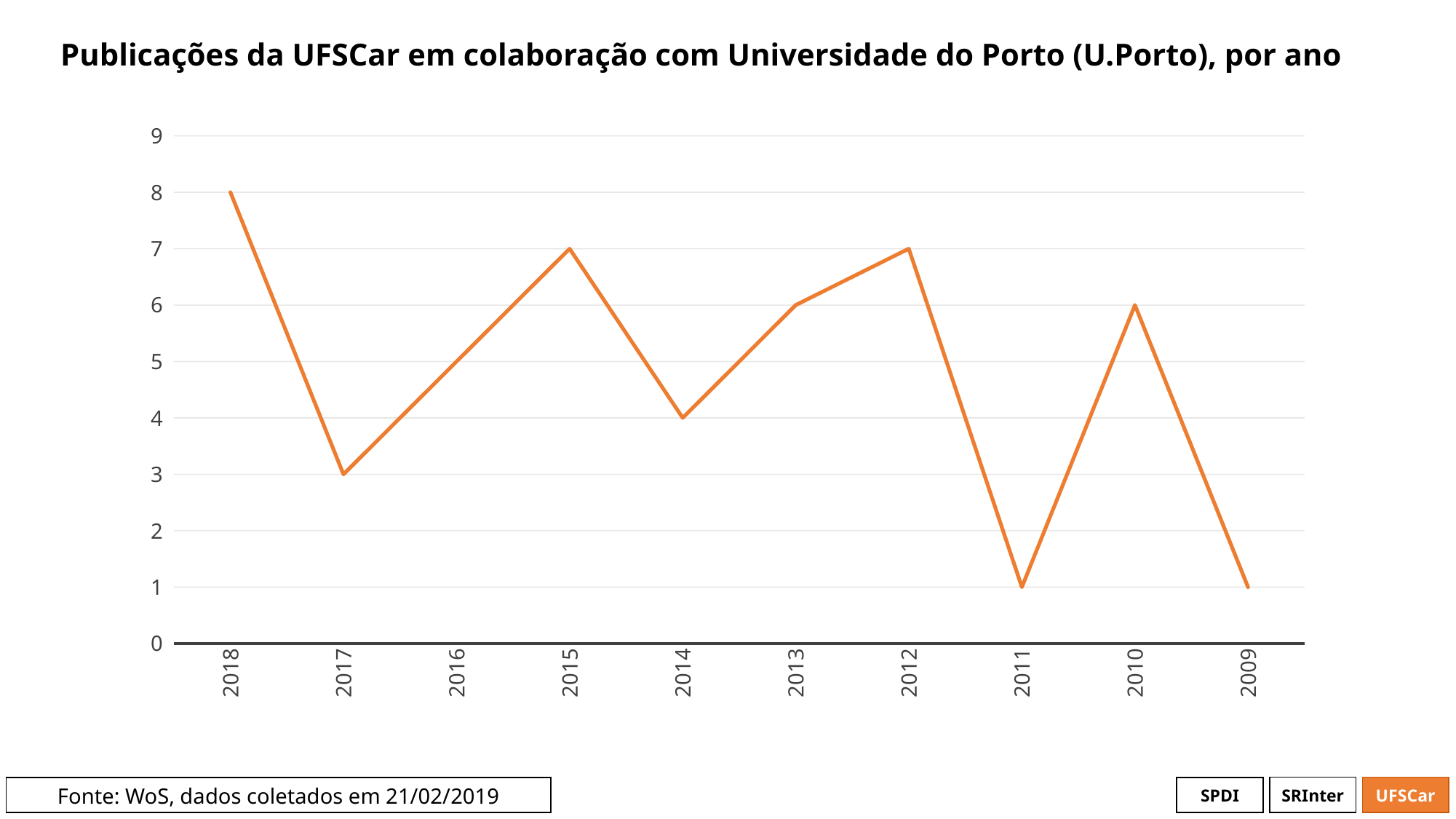
What is the difference between the values for 2018 and 2017? 5 What is the title of the chart? Publicações da UFSCar em colaboração com Universidade do Porto (U.Porto), por ano What is the value for 2012? 7 What type of chart is shown on the slide? line chart Which years share the lowest value? 2011 and 2009 How many years are plotted on the x axis? 10 What is the value for 2018? 8 Is the value for 2010 greater or less than 5? greater Which is larger, the value for 2015 or the value for 2014? 2015 What is the value for 2014? 4 What is the value for 2017? 3 Which year has the highest value? 2018